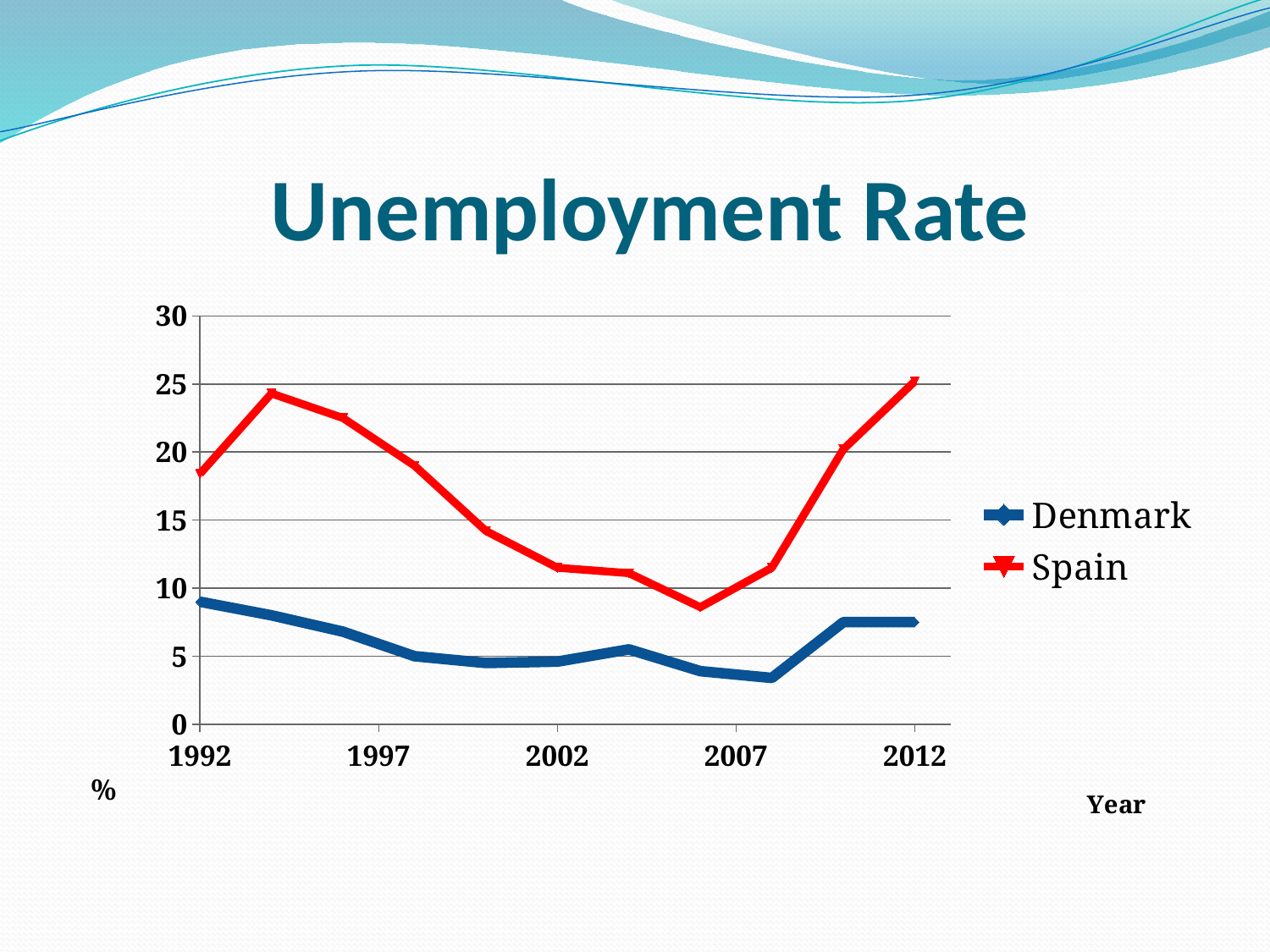
Does Spain's unemployment rate rise or fall between 2007 and 2012? rise What kind of chart is shown on the slide? line chart Is the unemployment rate for Denmark in 2012 greater or less than 10? less Is the unemployment rate for Spain in 2012 greater or less than 20? greater Which two countries are shown in the legend? Denmark and Spain Is the unemployment rate for Spain in 1992 greater or less than 15? greater Was Spain's unemployment rate higher in 1992 or in 2002? 1992 What is the title of the chart? Unemployment Rate How many series does the legend list? 2 Which country had the higher unemployment rate in 2012, Denmark or Spain? Spain